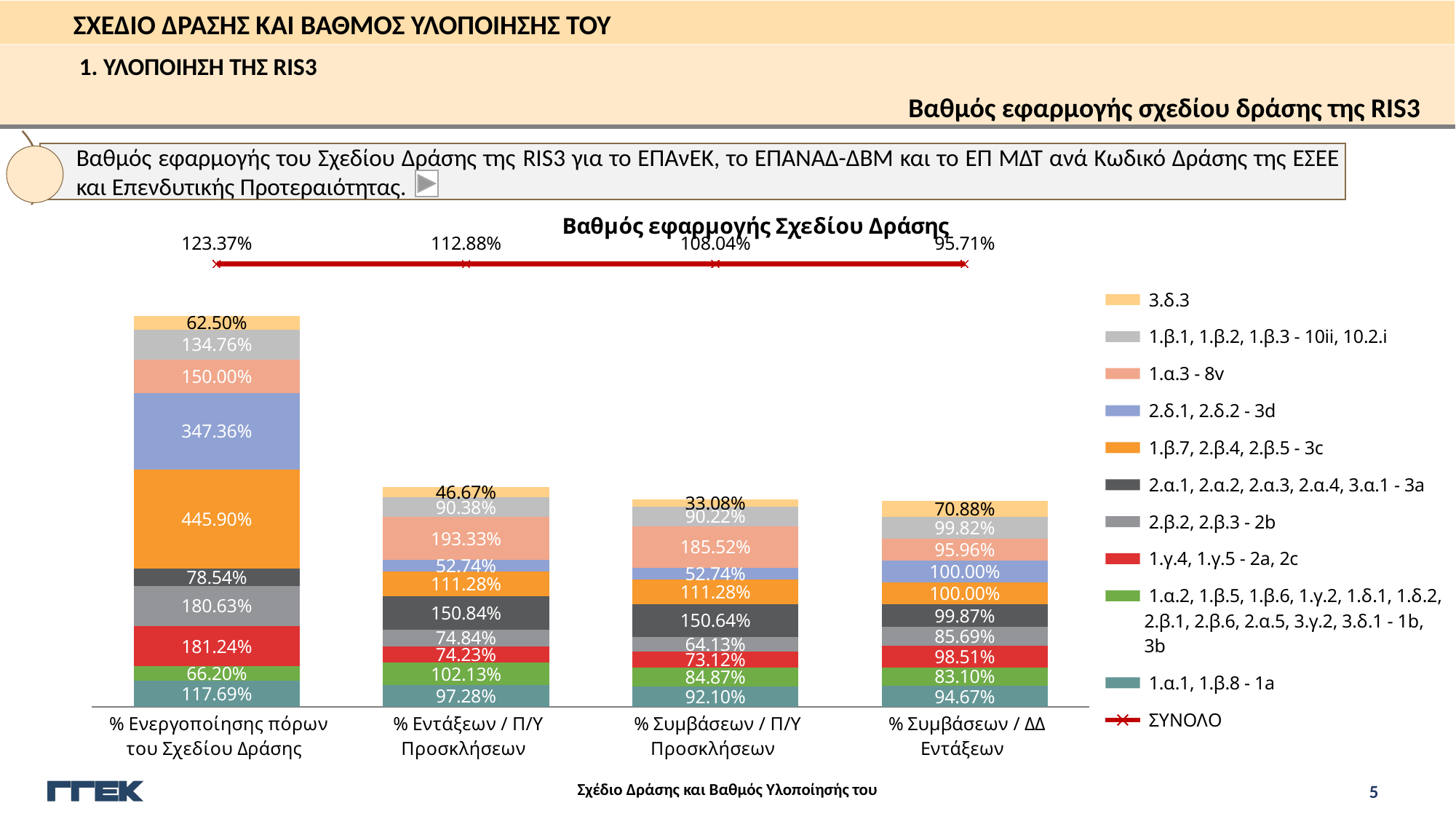
What is the difference between the ΣΥΝΟΛΟ values for '% Ενεργοποίησης πόρων του Σχεδίου Δράσης' and '% Συμβάσεων / ΔΔ Εντάξεων'? 27.66% Do the ΣΥΝΟΛΟ values rise or fall from left to right across the categories? Fall What is the ΣΥΝΟΛΟ value for the category '% Ενεργοποίησης πόρων του Σχεδίου Δράσης'? 123.37% Which category has the highest ΣΥΝΟΛΟ value? % Ενεργοποίησης πόρων του Σχεδίου Δράσης Which is larger: the '1.α.3 - 8v' value for '% Εντάξεων / Π/Υ Προσκλήσεων' or for '% Συμβάσεων / Π/Υ Προσκλήσεων'? % Εντάξεων / Π/Υ Προσκλήσεων What is the value of the '1.β.7, 2.β.4, 2.β.5 - 3c' series for '% Ενεργοποίησης πόρων του Σχεδίου Δράσης'? 445.90% How many series does the legend list? 11 What kind of chart is shown on the slide? Stacked bar chart with a line Which category has the lowest ΣΥΝΟΛΟ value? % Συμβάσεων / ΔΔ Εντάξεων How many categories are shown on the x axis of the chart? 4 What is the value of the '1.α.1, 1.β.8 - 1a' series for '% Εντάξεων / Π/Υ Προσκλήσεων'? 97.28% What is the value of the '3.δ.3' series for '% Συμβάσεων / Π/Υ Προσκλήσεων'? 33.08%